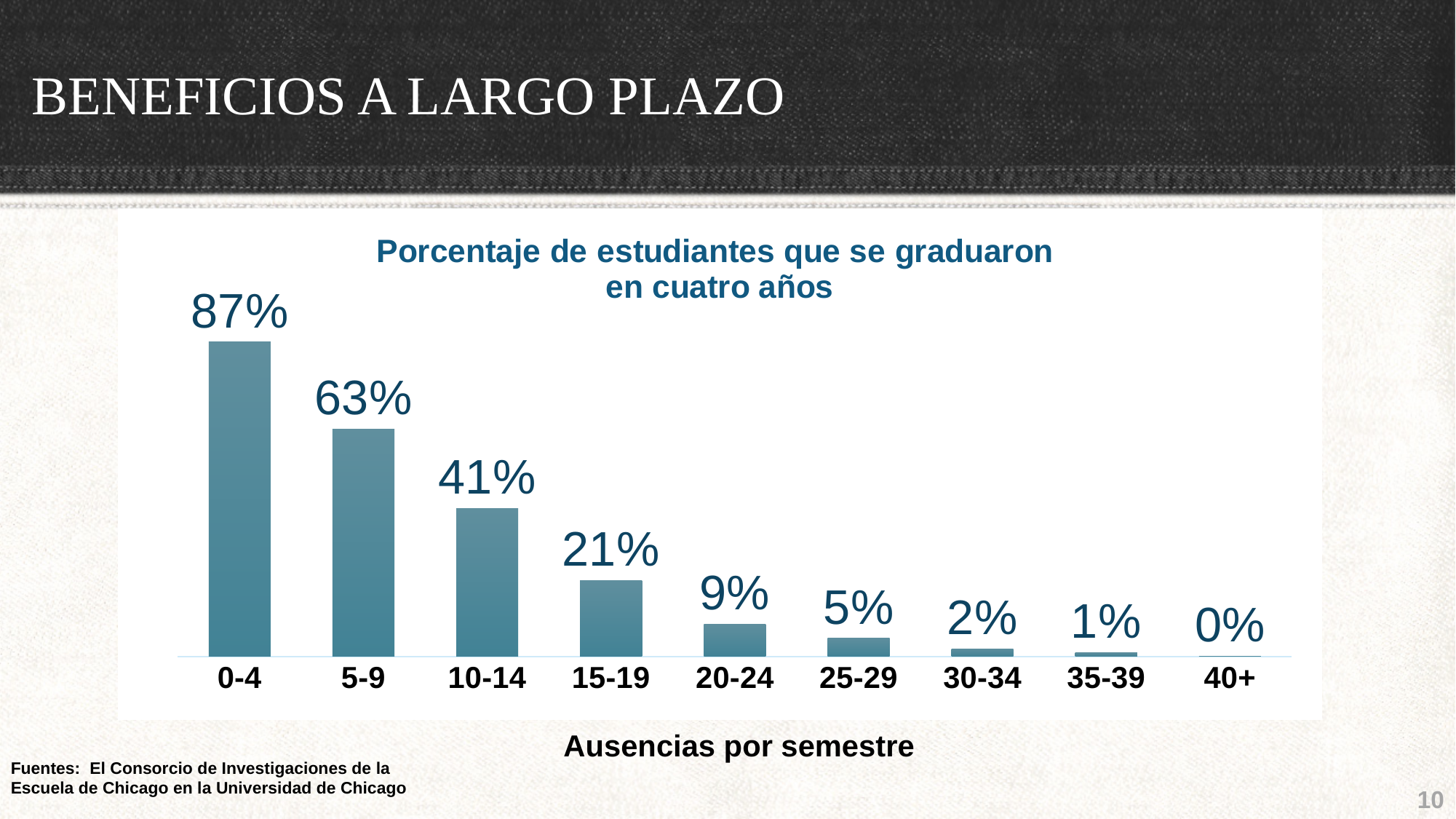
What is the value shown for the 10-14 absences category? 41% What is the title of the chart? Porcentaje de estudiantes que se graduaron en cuatro años What is the difference between the values for 15-19 and 20-24 absences? 12% How many absence categories are shown on the x axis? 9 What is the difference between the values for 0-4 and 5-9 absences? 24% Which is larger, the value for 5-9 absences or the value for 10-14 absences? 5-9 What is the value shown for the 25-29 absences category? 5% What kind of chart is shown on the slide? Bar chart Which absence category has the highest graduation percentage? 0-4 What percentage of students with 0-4 absences per semester graduated in four years? 87% Which absence category has the lowest graduation percentage? 40+ Do the values rise or fall as absences per semester increase along the x axis? Fall